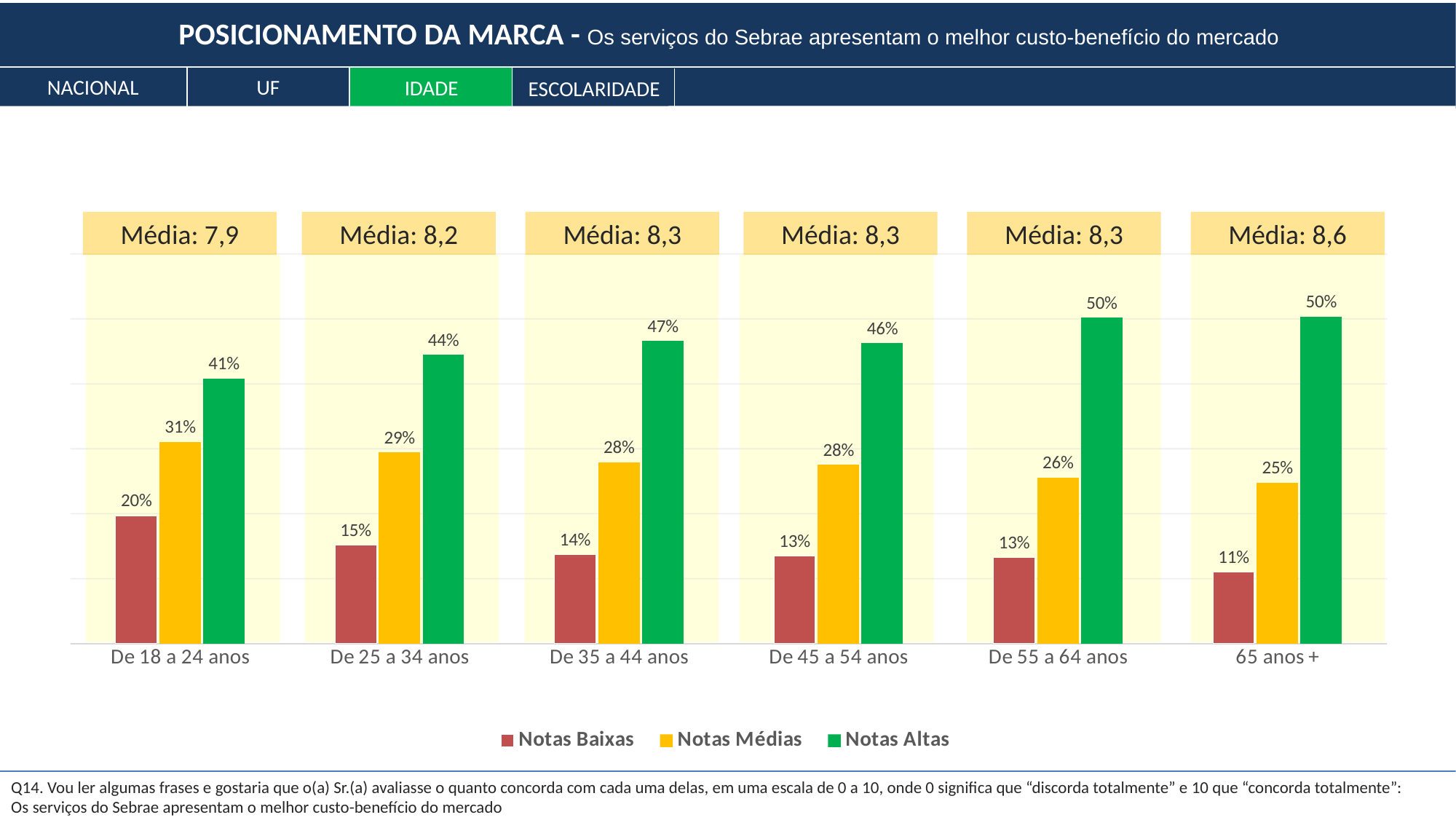
Which age group has the lowest Notas Médias value? 65 anos + What is the value of Notas Altas for De 18 a 24 anos? 41% Which age group has the highest Notas Baixas value? De 18 a 24 anos What is the value of Notas Médias for De 35 a 44 anos? 28% How many age groups are shown on the x axis? 6 What is the Média shown above the 65 anos + group? 8,6 Which is larger for De 25 a 34 anos: Notas Médias or Notas Baixas? Notas Médias Do the Notas Baixas values rise or fall from De 18 a 24 anos to 65 anos +? Fall What is the value of Notas Baixas for 65 anos +? 11% How many series does the legend list? 3 What kind of chart is shown on the slide? Bar chart What is the difference between Notas Altas and Notas Baixas for De 55 a 64 anos? 37%